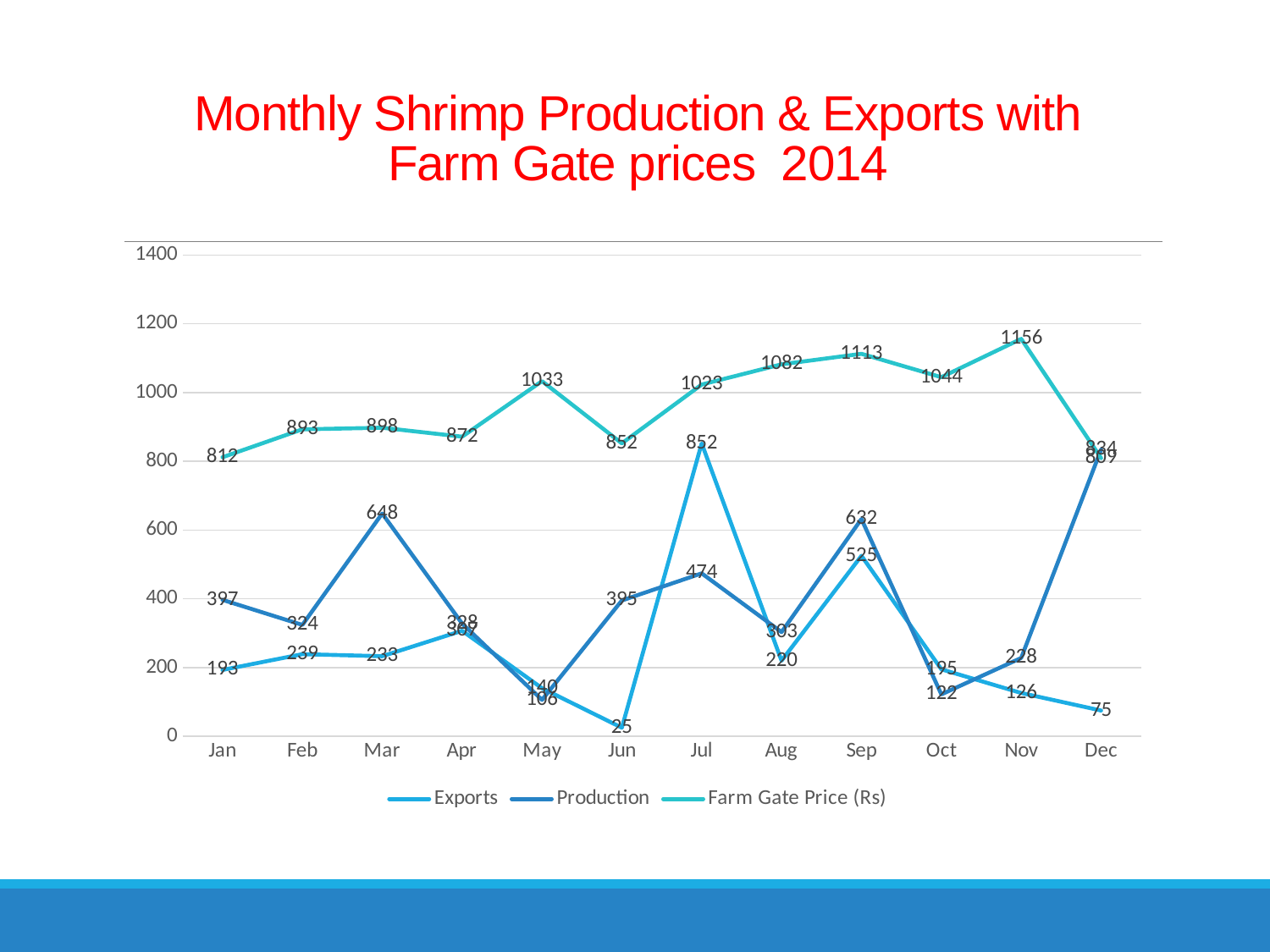
How many months are plotted along the x axis? 12 What is the difference between the Farm Gate Price (Rs) in Sep and in Aug? 31 In which month are Exports lowest? Jun In which month is the Farm Gate Price (Rs) highest? Nov What is the value of Exports in Jul? 852 What is the Farm Gate Price (Rs) in Nov? 1156 What kind of chart is shown on the slide? line chart How many series does the legend list? 3 In Sep, which is larger: Production or Exports? Production What is the value of Production in Mar? 648 Does the Farm Gate Price (Rs) rise or fall from Jun to Sep? rise Is the Farm Gate Price (Rs) in May greater or less than 1000? greater